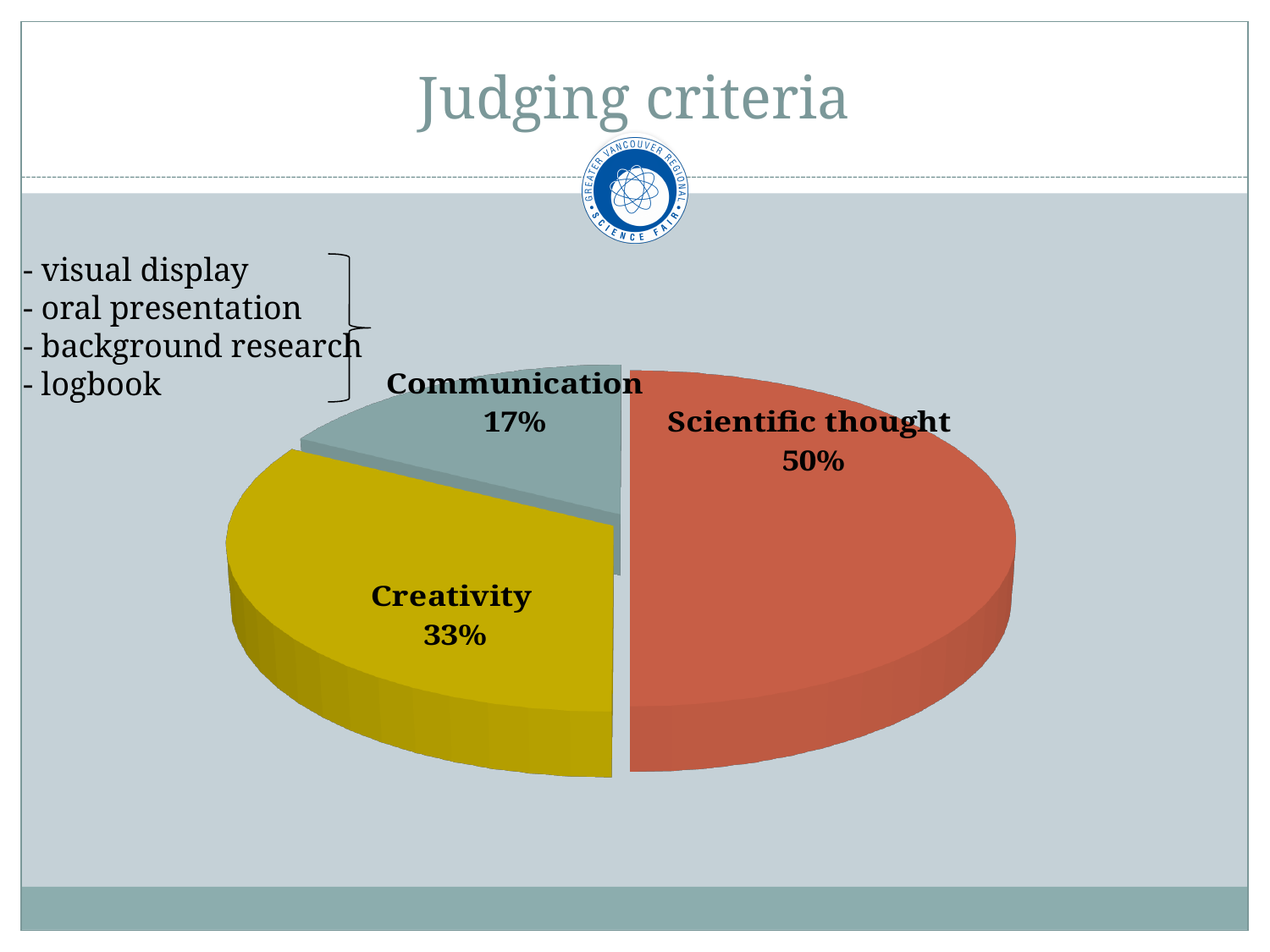
What percentage of the judging criteria is Communication? 17% What percentage of the judging criteria is Scientific thought? 50% What is the difference in percentage points between Scientific thought and Creativity? 17 What colour is the Creativity slice of the pie chart? Yellow Which is larger, the share for Creativity or the share for Communication? Creativity What is the difference in percentage points between Creativity and Communication? 16 What is the title of the slide containing the chart? Judging criteria How many slices does the pie chart have? 3 What percentage of the judging criteria is Creativity? 33% What kind of chart is shown on the slide? Pie chart Which judging criterion has the largest share of the pie? Scientific thought Which judging criterion has the smallest share of the pie? Communication